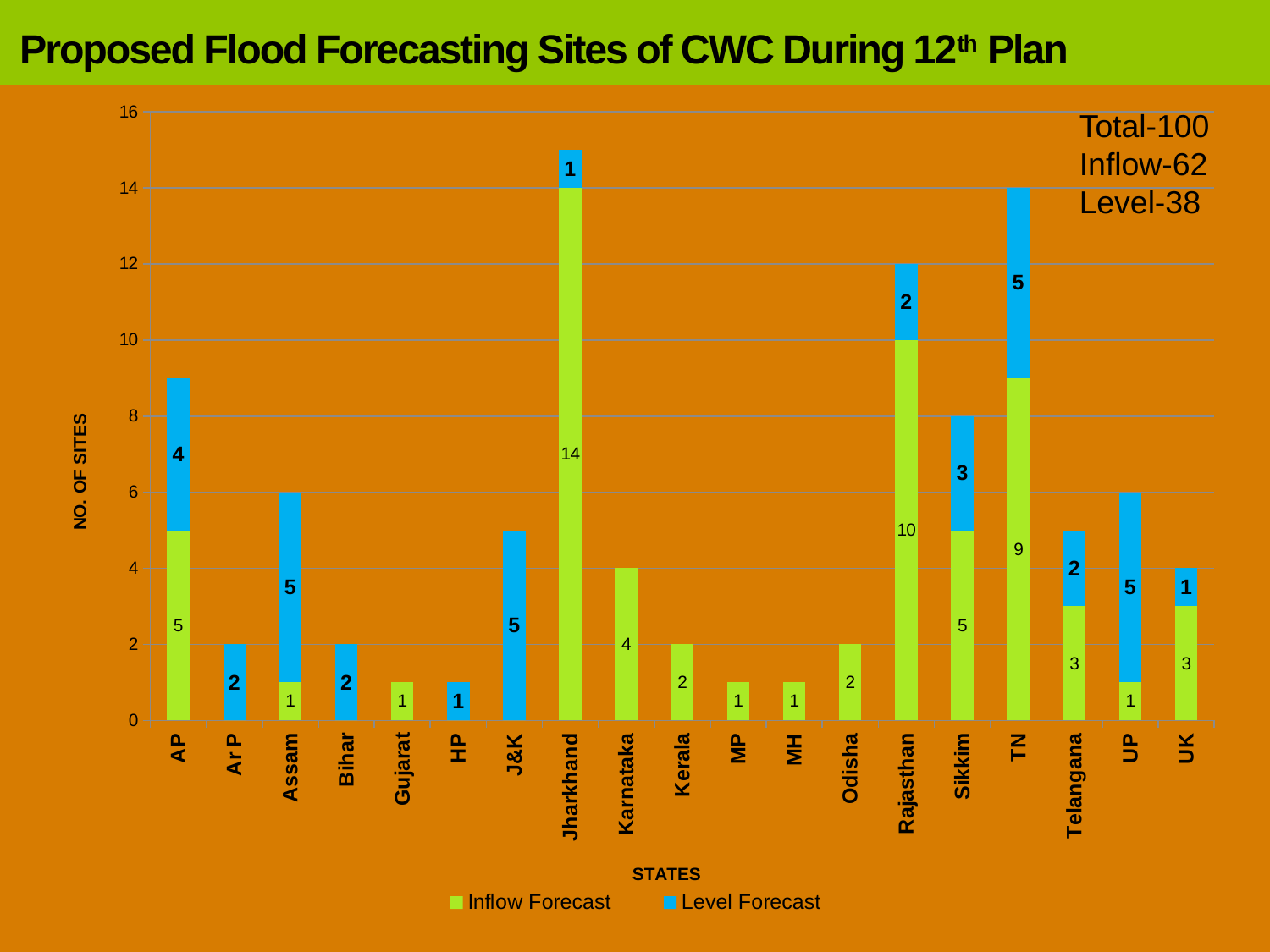
According to the text on the chart, what is the total number of proposed sites? 100 What is the Inflow Forecast value for Jharkhand? 14 What is the difference between the Inflow Forecast values for Jharkhand and Rajasthan? 4 What is the total number of sites for AP (Inflow Forecast plus Level Forecast)? 9 How many series does the legend list? 2 What is the Level Forecast value for TN? 5 What is the Inflow Forecast value for Rajasthan? 10 Which state has the highest Inflow Forecast value? Jharkhand Which state has the larger Level Forecast value, Assam or Sikkim? Assam What kind of chart is shown on the slide? Stacked bar chart How many states are shown on the x axis? 19 What is the total number of sites for Sikkim (Inflow Forecast plus Level Forecast)? 8